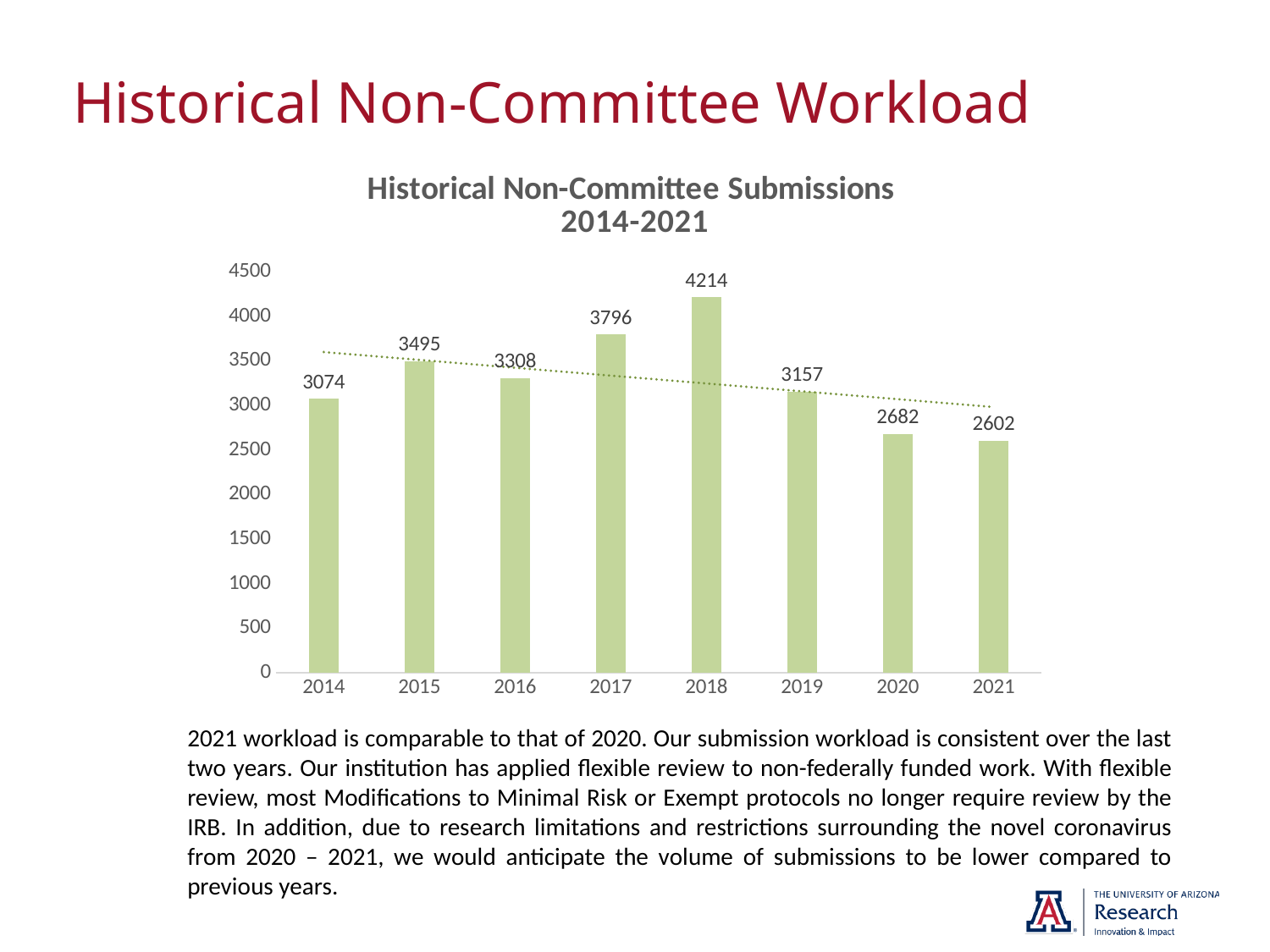
What is the difference between the submissions in 2018 and 2021? 1612 Which year has the lowest number of non-committee submissions? 2021 Which year has the highest number of non-committee submissions? 2018 Is the value for 2019 greater or less than 3000? greater What is the title of the chart? Historical Non-Committee Submissions 2014-2021 What is the number of non-committee submissions in 2014? 3074 How many years are shown on the x axis of the chart? 8 What kind of chart is shown on the slide? bar chart What is the number of non-committee submissions in 2021? 2602 What is the difference between the submissions in 2020 and 2021? 80 What is the number of non-committee submissions in 2018? 4214 Which year had more submissions, 2015 or 2016? 2015